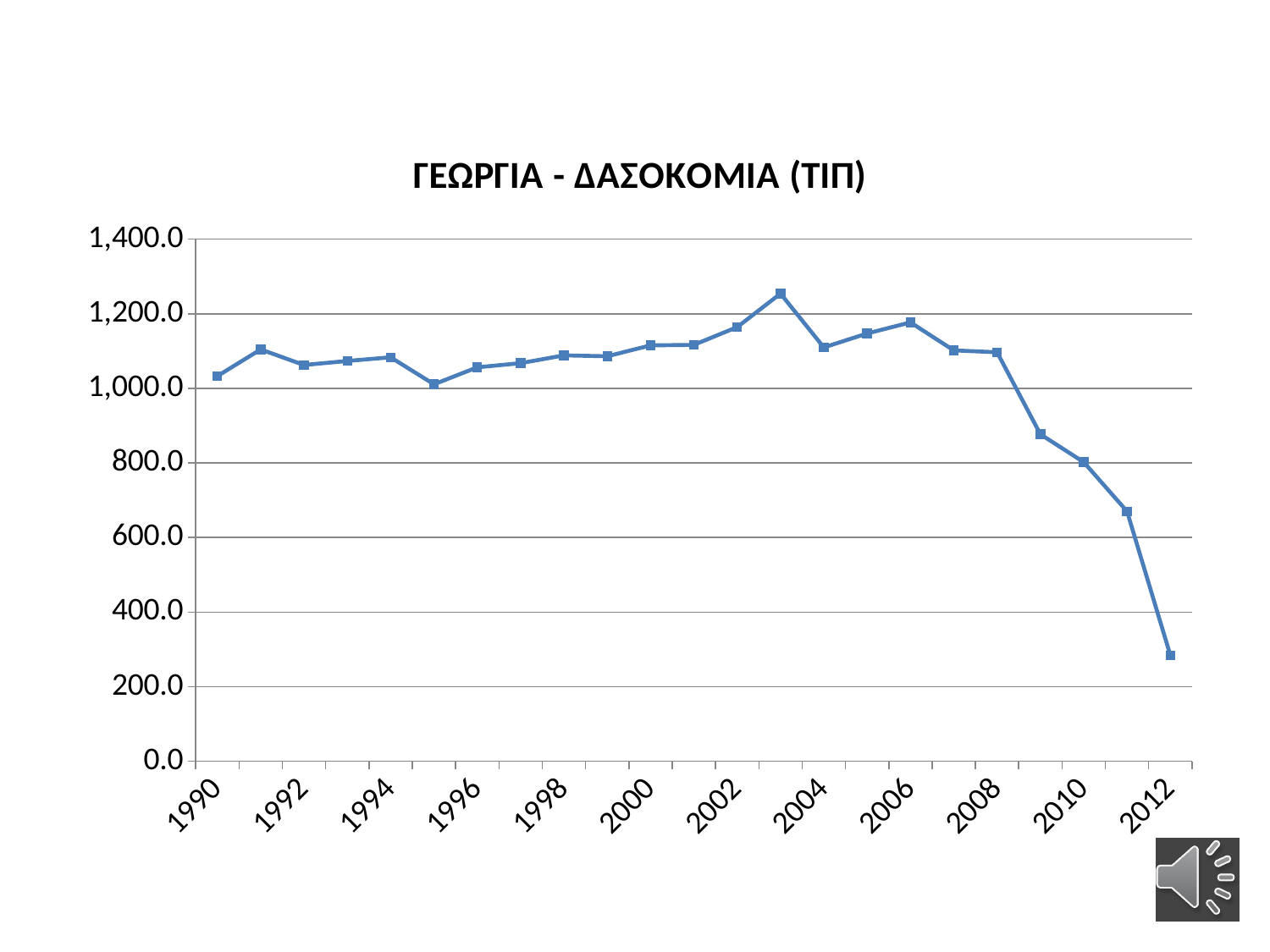
Is the value for 2003 greater or less than 1,200.0? greater Is the value for 2009 greater or less than 800.0? greater Do the values rise or fall from 2008 to 2012? fall Which year has the larger value, 2011 or 2012? 2011 Which year has the larger value, 2003 or 2004? 2003 In which year does the line reach its highest value? 2003 Is the value for 2011 greater or less than 600.0? greater In which year does the line reach its lowest value? 2012 What is the title of the chart? ΓΕΩΡΓΙΑ - ΔΑΣΟΚΟΜΙΑ (ΤΙΠ) How many data points are plotted on the line? 23 What kind of chart is shown on the slide? line chart